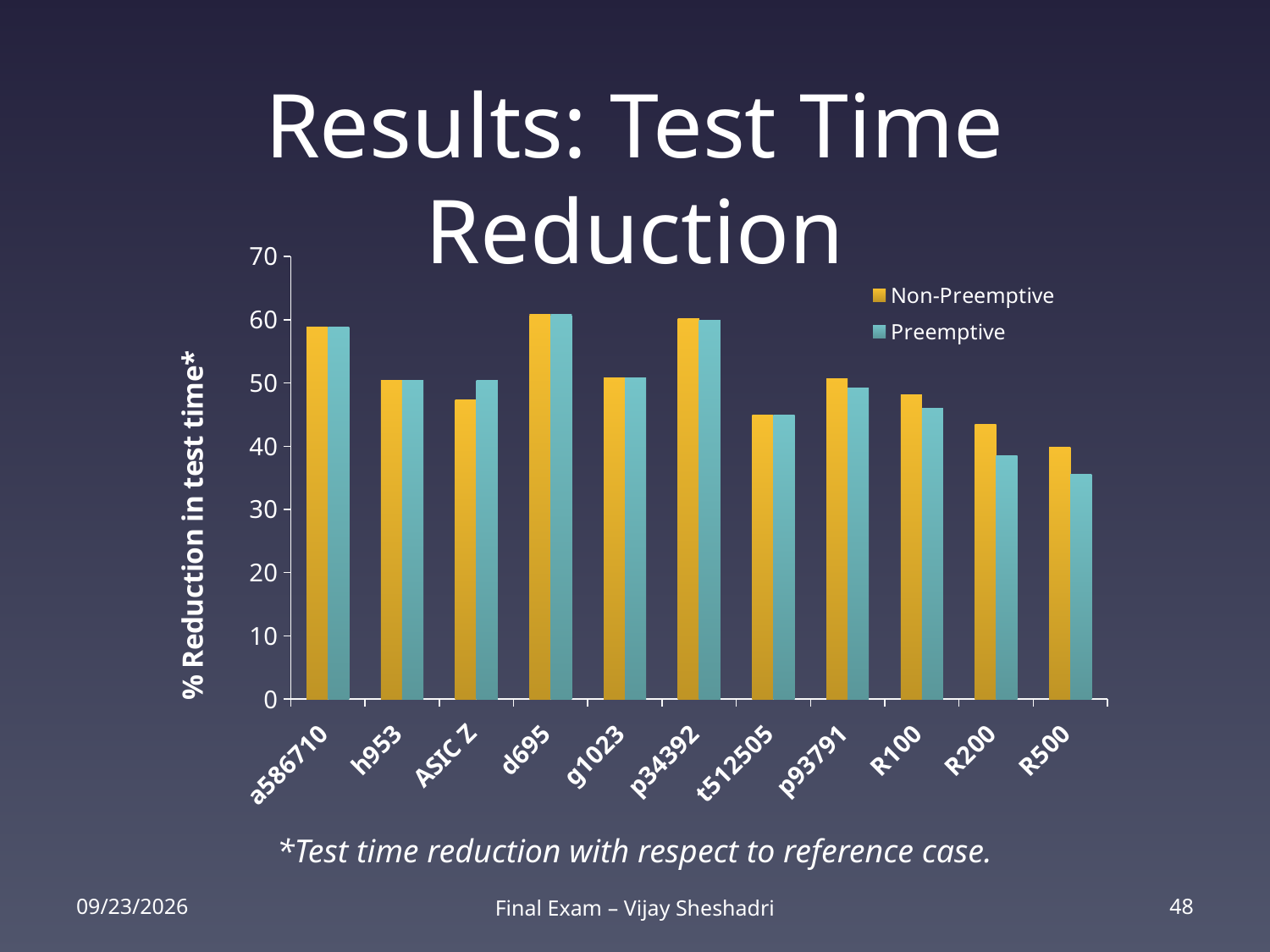
What is the label of the y axis? % Reduction in test time* Which category has the lowest Preemptive value? R500 For R200, which series has the larger value, Non-Preemptive or Preemptive? Non-Preemptive How many categories are shown on the x axis? 11 How many series does the legend list? 2 For ASIC Z, which series has the larger value, Non-Preemptive or Preemptive? Preemptive Is the Preemptive value for R500 greater or less than 40? less Is the Non-Preemptive value for t512505 greater or less than 50? less Which category has the lowest Non-Preemptive value? R500 What kind of chart is shown on the slide? bar chart Is the Non-Preemptive value for a586710 greater or less than 50? greater